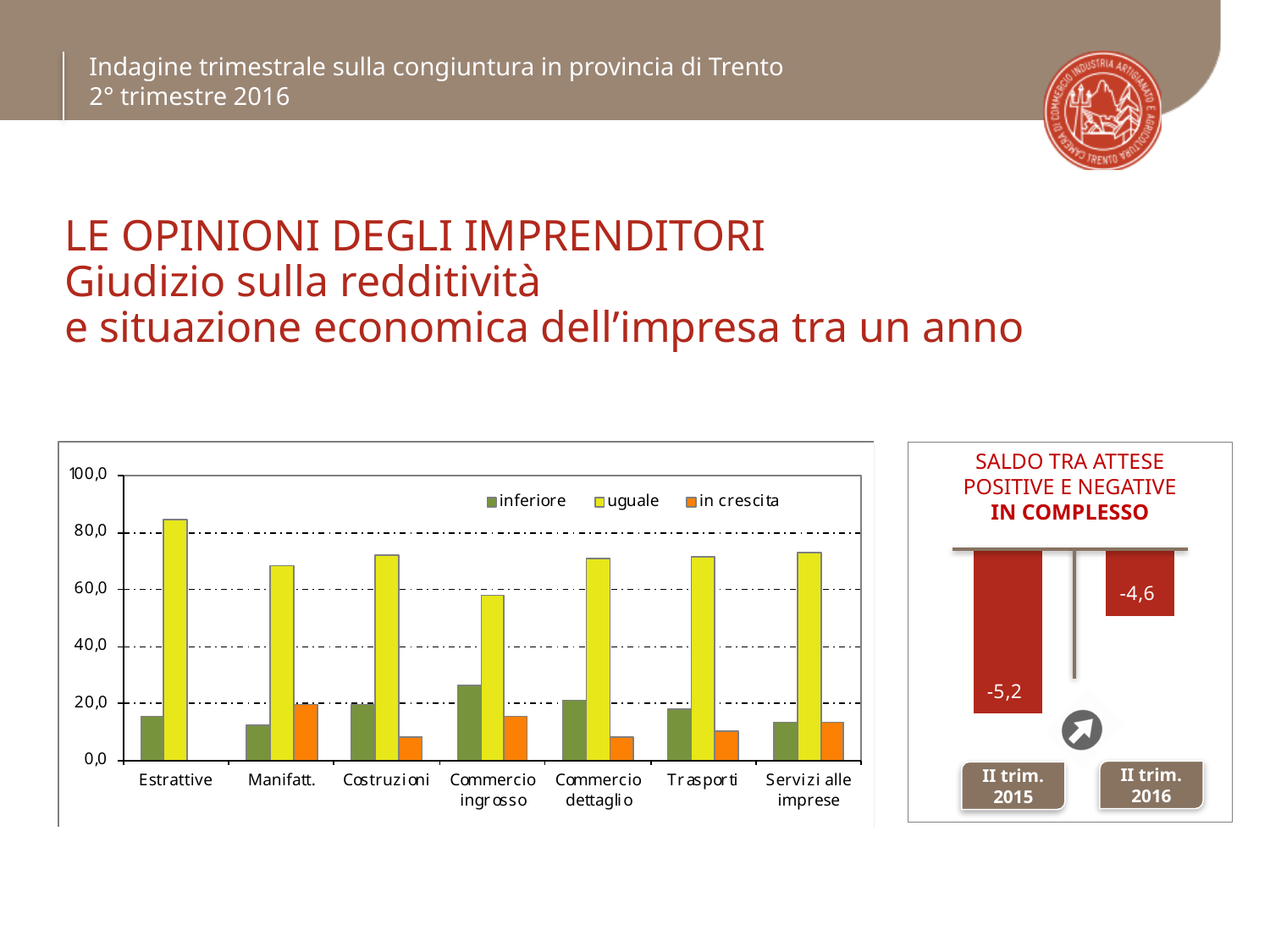
On the chart 'SALDO TRA ATTESE POSITIVE E NEGATIVE IN COMPLESSO', what is the value for II trim. 2016? -4,6 On the left chart, which category has the highest value for the 'inferiore' series? Commercio ingrosso On the left chart, is the 'uguale' value for Commercio ingrosso greater or less than 60,0? less What kind of chart is the left chart? bar chart On the chart 'SALDO TRA ATTESE POSITIVE E NEGATIVE IN COMPLESSO', what is the difference between the II trim. 2016 and II trim. 2015 values? 0,6 On the left chart, which category has the lowest value for the 'uguale' series? Commercio ingrosso On the left chart, is the 'uguale' value for Estrattive greater or less than 80,0? greater On the left chart, how many sector categories are shown on the x axis? 7 On the left chart, which category has the highest value for the 'uguale' series? Estrattive On the left chart, is the 'inferiore' value for Commercio ingrosso greater or less than 20,0? greater On the left chart, how many series does the legend list? 3 On the chart 'SALDO TRA ATTESE POSITIVE E NEGATIVE IN COMPLESSO', what is the value for II trim. 2015? -5,2